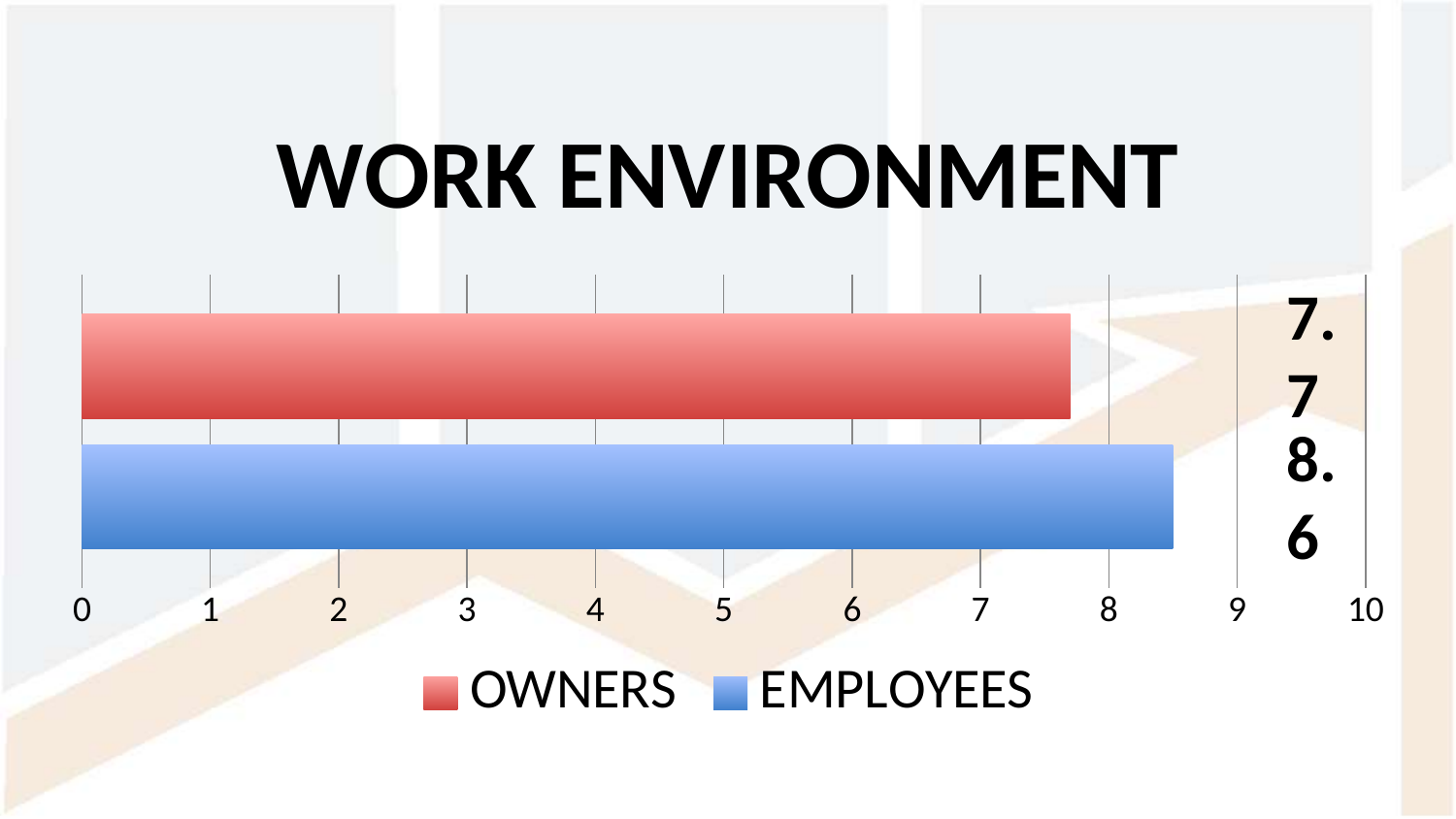
Is the value for EMPLOYEES greater or less than 8? greater Is the value for OWNERS greater or less than 8? less What is the value for EMPLOYEES in the Work Environment chart? 8.6 Which series has the lowest value in the chart? OWNERS What kind of chart is shown on the slide? bar chart Which series has the higher value, OWNERS or EMPLOYEES? EMPLOYEES How many series does the legend list? 2 What is the difference between the EMPLOYEES value and the OWNERS value? 0.9 What is the value for OWNERS in the Work Environment chart? 7.7 What colour is the EMPLOYEES bar? blue What is the title of the chart? WORK ENVIRONMENT Which series has the highest value in the chart? EMPLOYEES